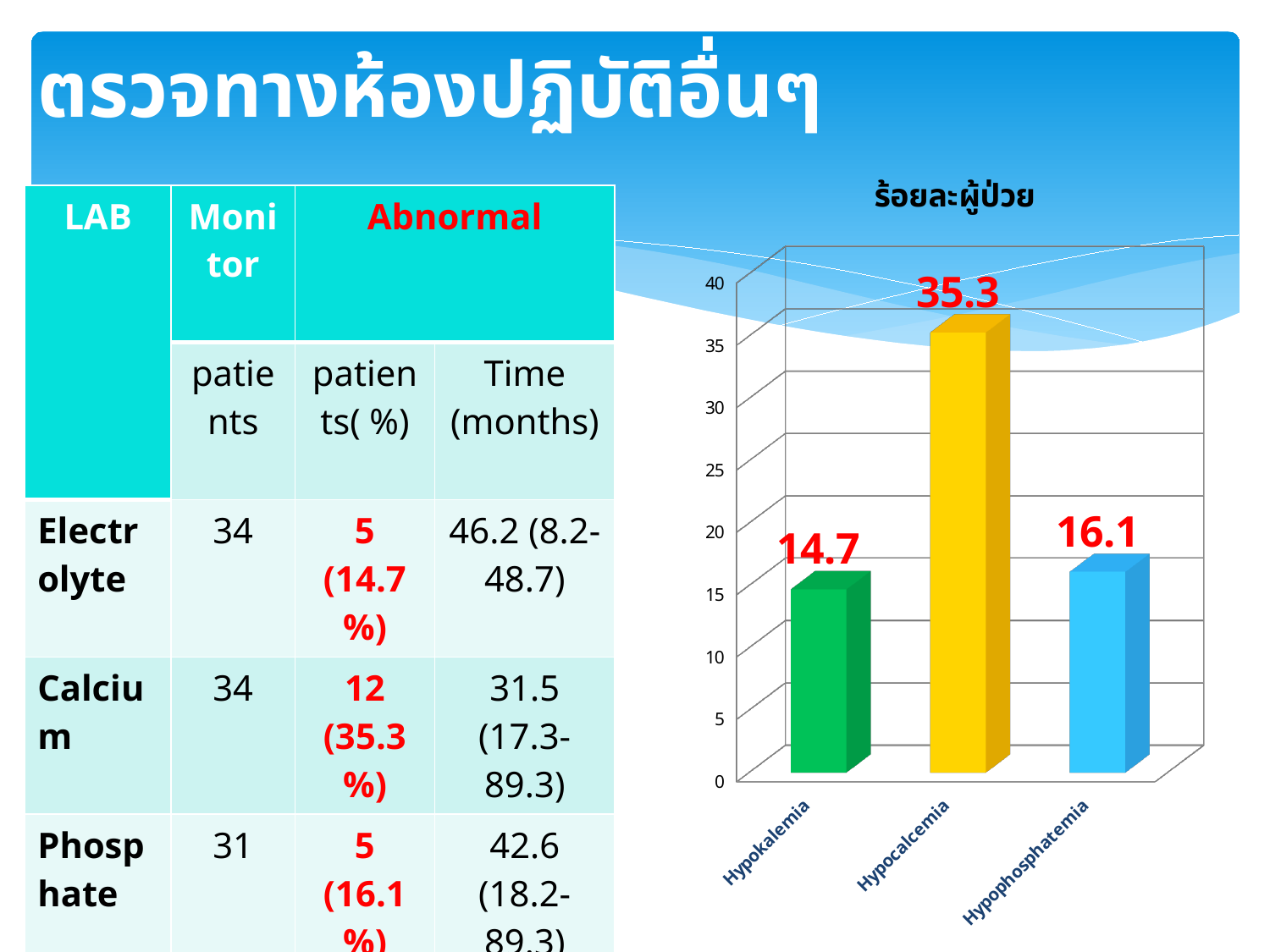
What is the difference between the values for Hypophosphatemia and Hypokalemia? 1.4 What is the difference between the values for Hypocalcemia and Hypokalemia? 20.6 What is the value for Hypophosphatemia in the chart? 16.1 How many categories are shown in the chart? 3 What kind of chart is shown on the slide? bar chart Which category has the highest value in the chart? Hypocalcemia What colour is the bar for Hypocalcemia? yellow What is the value for Hypokalemia in the chart? 14.7 Which category has the lowest value in the chart? Hypokalemia What is the value for Hypocalcemia in the chart? 35.3 Which is larger, the value for Hypocalcemia or the value for Hypophosphatemia? Hypocalcemia Is the value for Hypocalcemia greater or less than 30? greater